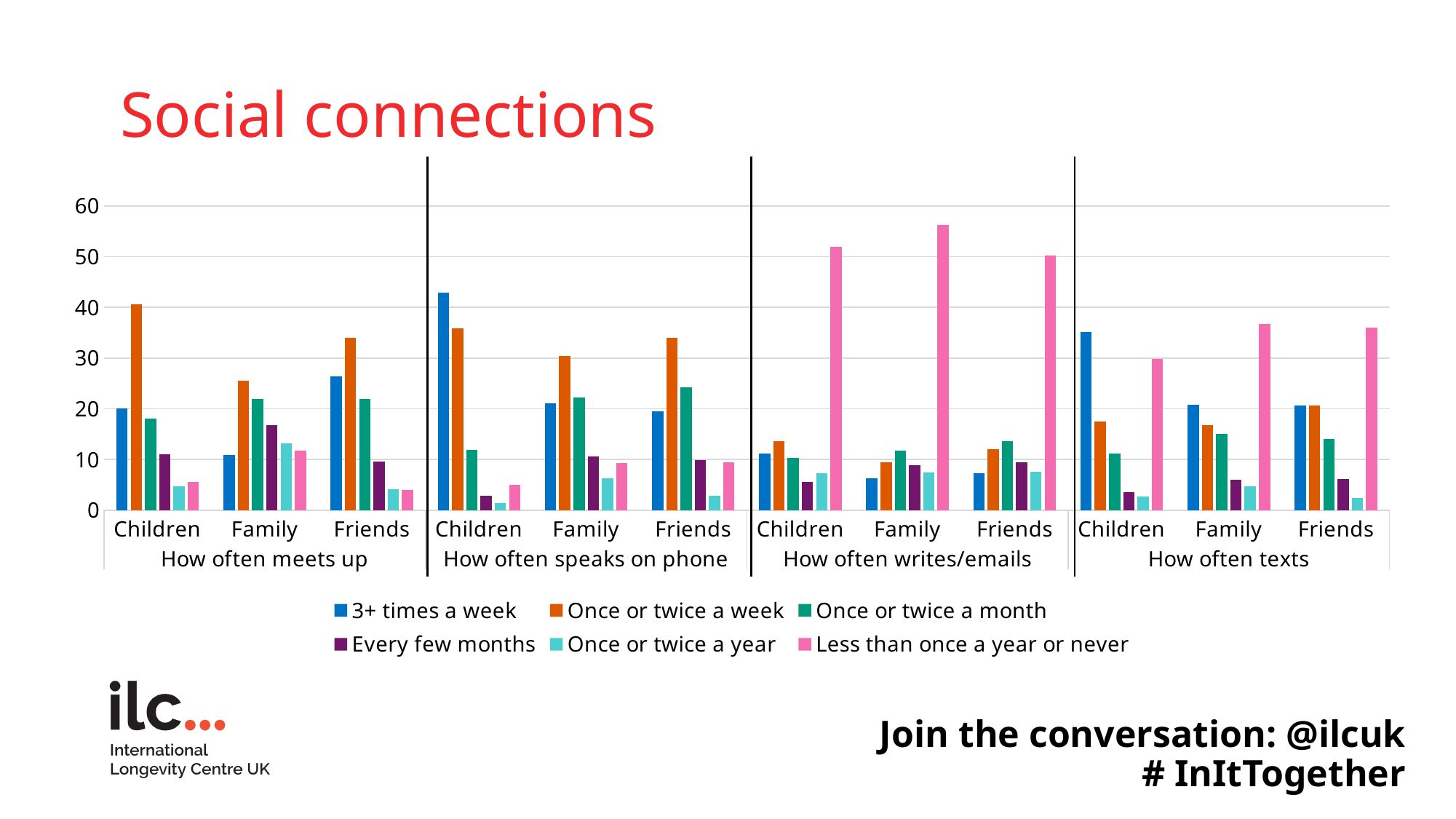
Is the value for '3+ times a week' for Children in the 'How often speaks on phone' panel greater or less than 40? greater Which series has the tallest bar in the 'How often writes/emails' panel for Family? Less than once a year or never Is the value for 'Once or twice a year' for Children in the 'How often meets up' panel greater or less than 10? less In the 'How often texts' panel, which is larger for Children: '3+ times a week' or 'Less than once a year or never'? 3+ times a week Is the value for 'Less than once a year or never' for Family in the 'How often writes/emails' panel greater or less than 50? greater What kind of chart is shown on the slide? bar chart In the 'How often meets up' panel, which is larger for Friends: '3+ times a week' or 'Once or twice a week'? Once or twice a week Which series has the tallest bar for Children in the 'How often speaks on phone' panel? 3+ times a week How many panels (contact methods) does the chart divide the x axis into? 4 What is the title of the slide? Social connections How many series does the legend list? 6 Which series has the tallest bar for Children in the 'How often meets up' panel? Once or twice a week